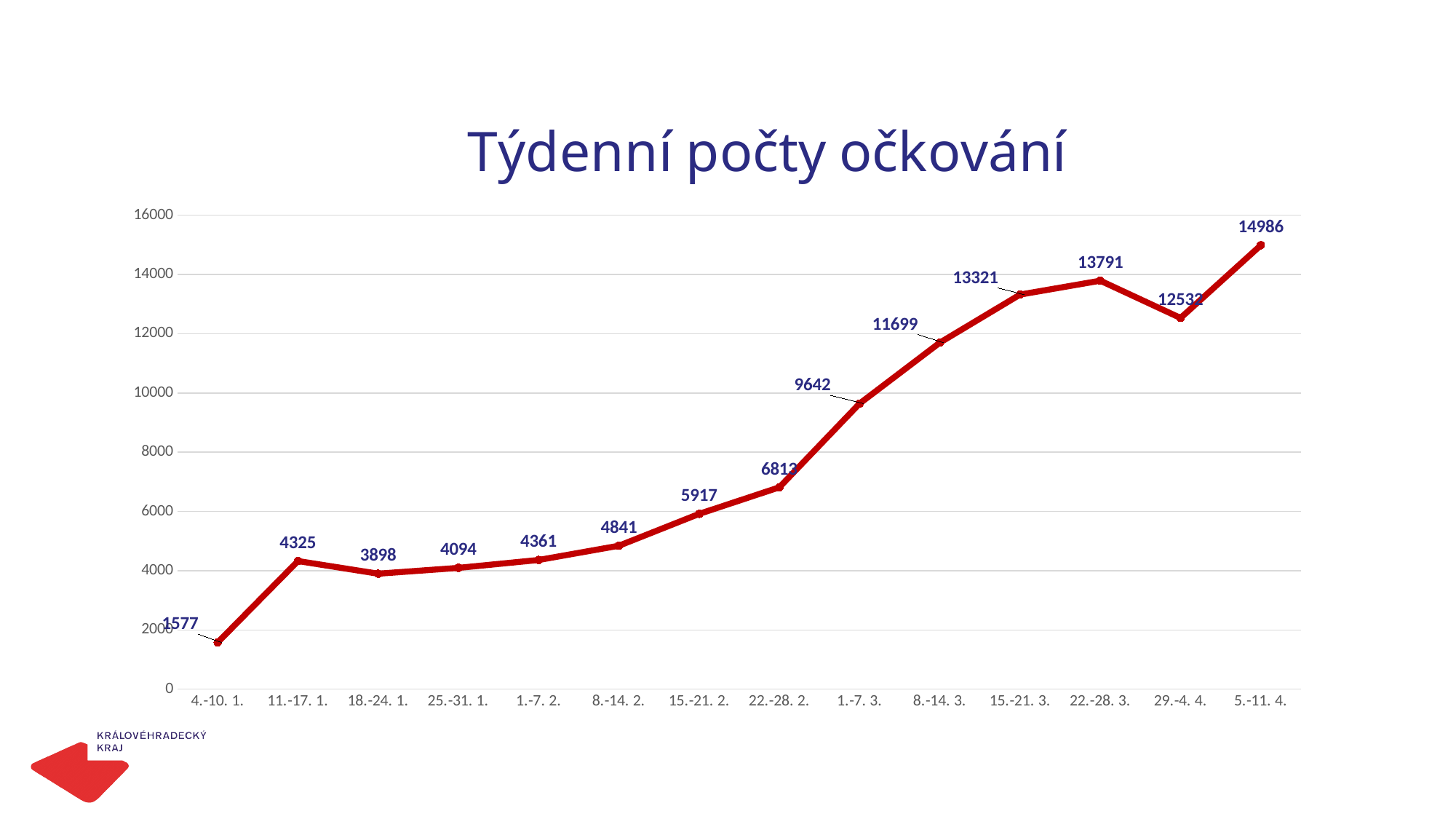
What kind of chart is shown on the slide? line chart Which week has the lowest value? 4.-10. 1. How many weeks are plotted on the chart? 14 What is the value for the week 4.-10. 1.? 1577 What is the difference between the values for 15.-21. 3. and 8.-14. 3.? 1622 Do the values generally rise or fall from the first week to the last week? rise What is the value for the week 1.-7. 3.? 9642 What is the value for the week 5.-11. 4.? 14986 Is the value for 29.-4. 4. greater or less than 12000? greater Which is larger, the value for 11.-17. 1. or for 18.-24. 1.? 11.-17. 1. What is the difference between the values for 5.-11. 4. and 22.-28. 3.? 1195 Which week has the highest value? 5.-11. 4.